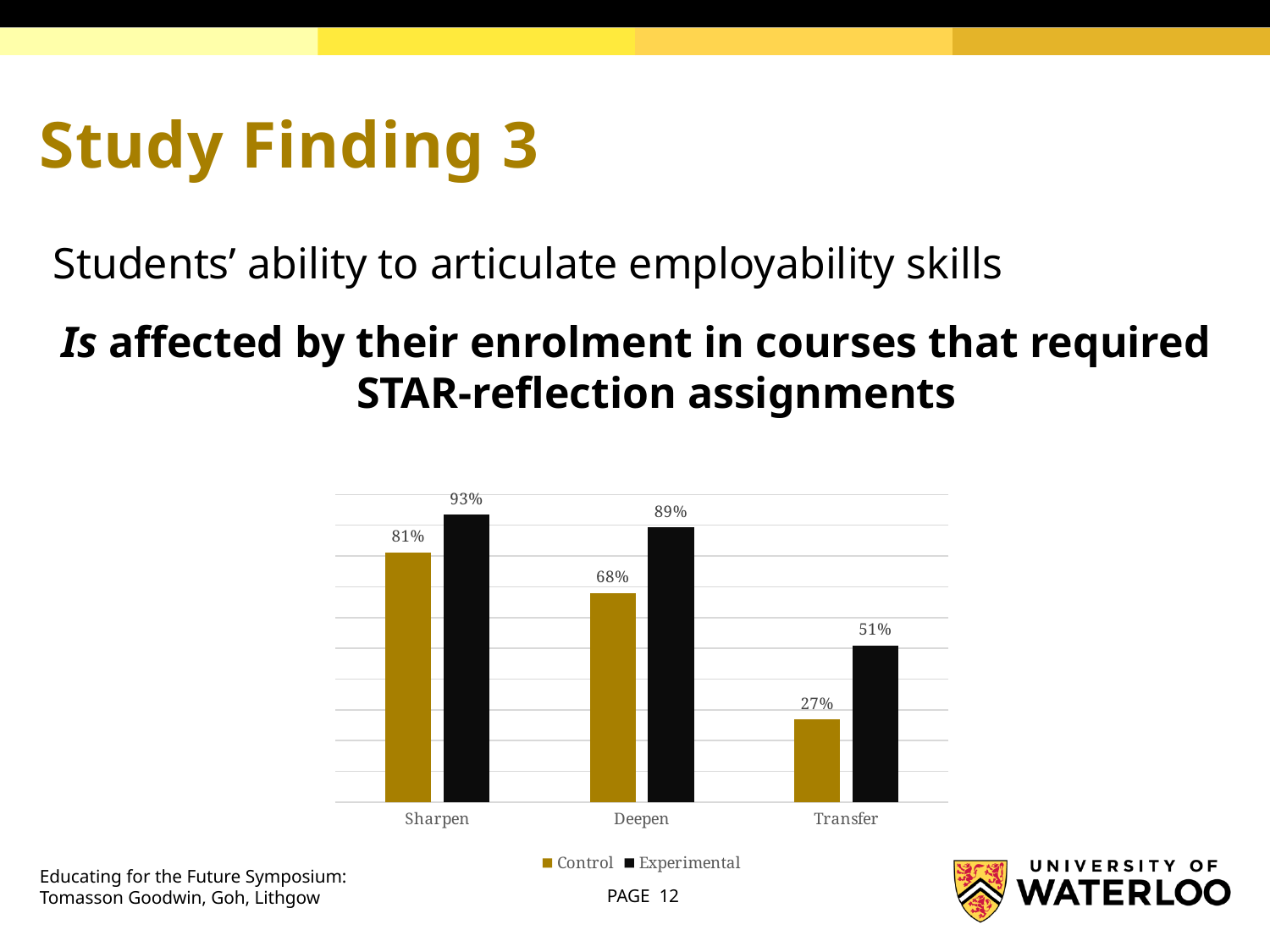
Do the Control values rise or fall from Sharpen to Transfer? Fall What is the Experimental value for Deepen? 89% Which category has the highest Experimental value? Sharpen Which is larger for Transfer, the Control value or the Experimental value? Experimental What is the Control value for Sharpen? 81% Which category has the lowest Control value? Transfer What is the Control value for Transfer? 27% How many categories are shown on the x axis? 3 What is the difference between the Experimental and Control values for Deepen? 21% What is the Experimental value for Transfer? 51% How many series does the legend list? 2 What kind of chart is shown on the slide? Bar chart